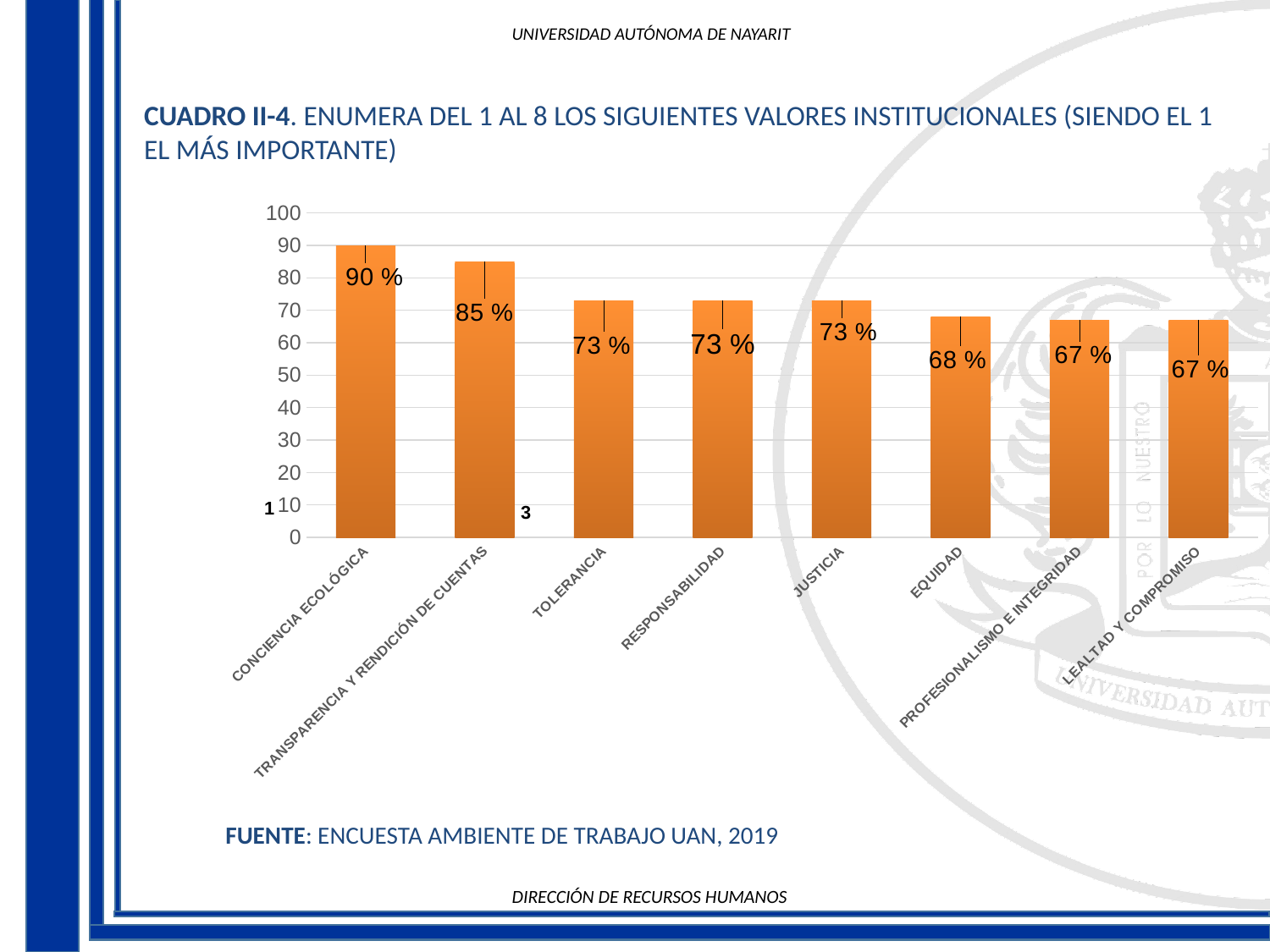
What is the value for EQUIDAD? 68 % What is the value for LEALTAD Y COMPROMISO? 67 % How many categories are shown on the x axis? 8 What is the value for CONCIENCIA ECOLÓGICA? 90 % Which is larger, the value for JUSTICIA or the value for PROFESIONALISMO E INTEGRIDAD? JUSTICIA What is the difference between the values for TOLERANCIA and EQUIDAD? 5 % What kind of chart is shown on the slide? bar chart What is the difference between the values for CONCIENCIA ECOLÓGICA and TRANSPARENCIA Y RENDICIÓN DE CUENTAS? 5 % What is the value for TRANSPARENCIA Y RENDICIÓN DE CUENTAS? 85 % Do the values generally rise or fall from left to right along the x axis? fall Is the value for RESPONSABILIDAD greater or less than 80? less Which category has the highest value? CONCIENCIA ECOLÓGICA